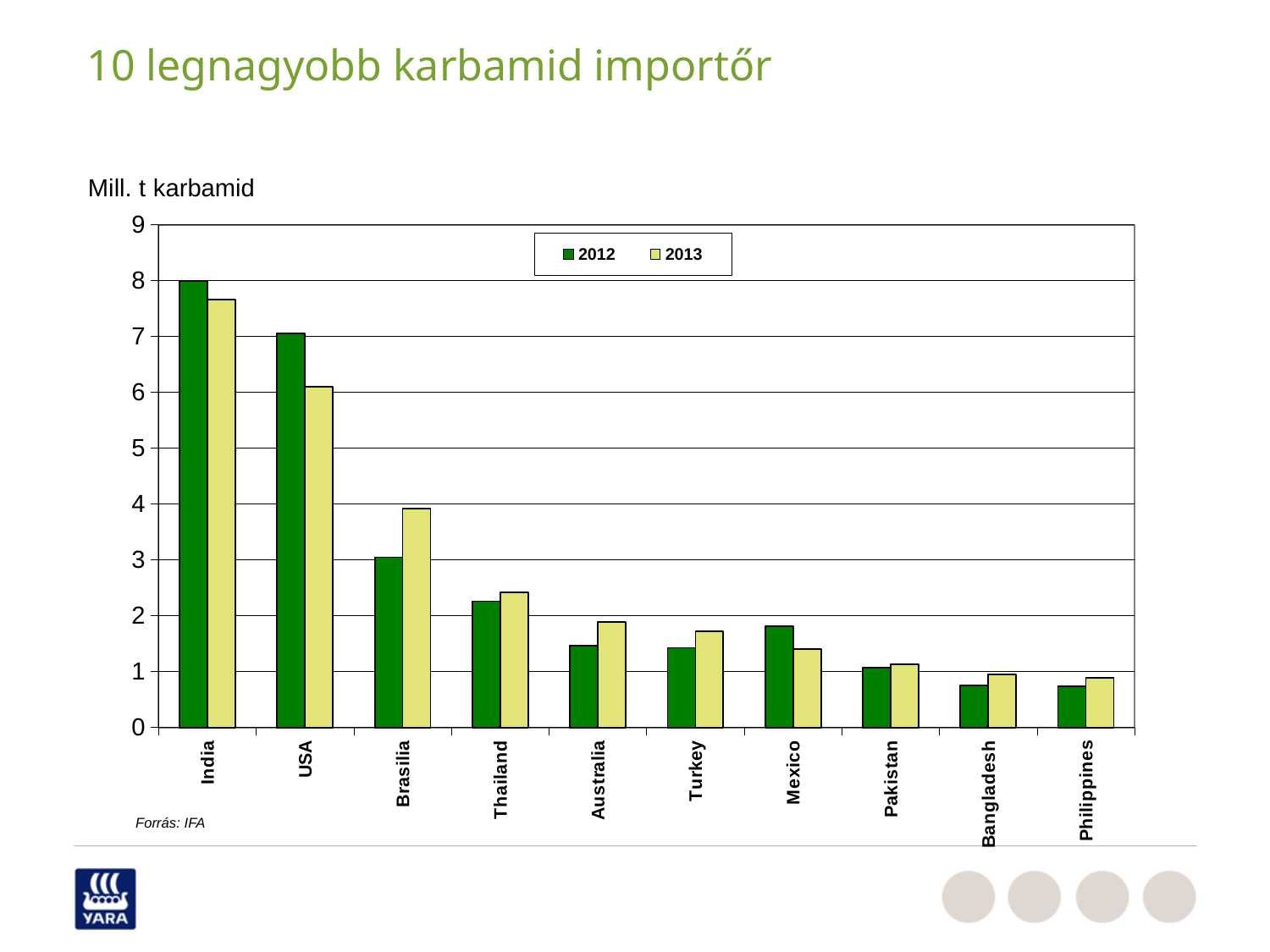
What source is cited below the chart? IFA Is the 2013 value for India greater or less than 7? greater Is the 2012 value for Pakistan greater or less than 2? less Which is larger for 2013: Turkey or Mexico? Turkey Which country has the highest value for 2013? India How many countries are shown on the x axis? 10 For the USA, which year has the larger value, 2012 or 2013? 2012 How many series does the legend list? 2 For Brasilia, which year has the larger value, 2012 or 2013? 2013 What kind of chart is shown on the slide? bar chart Which country has the highest value for 2012? India Is the 2013 value for Brasilia greater or less than 3? greater